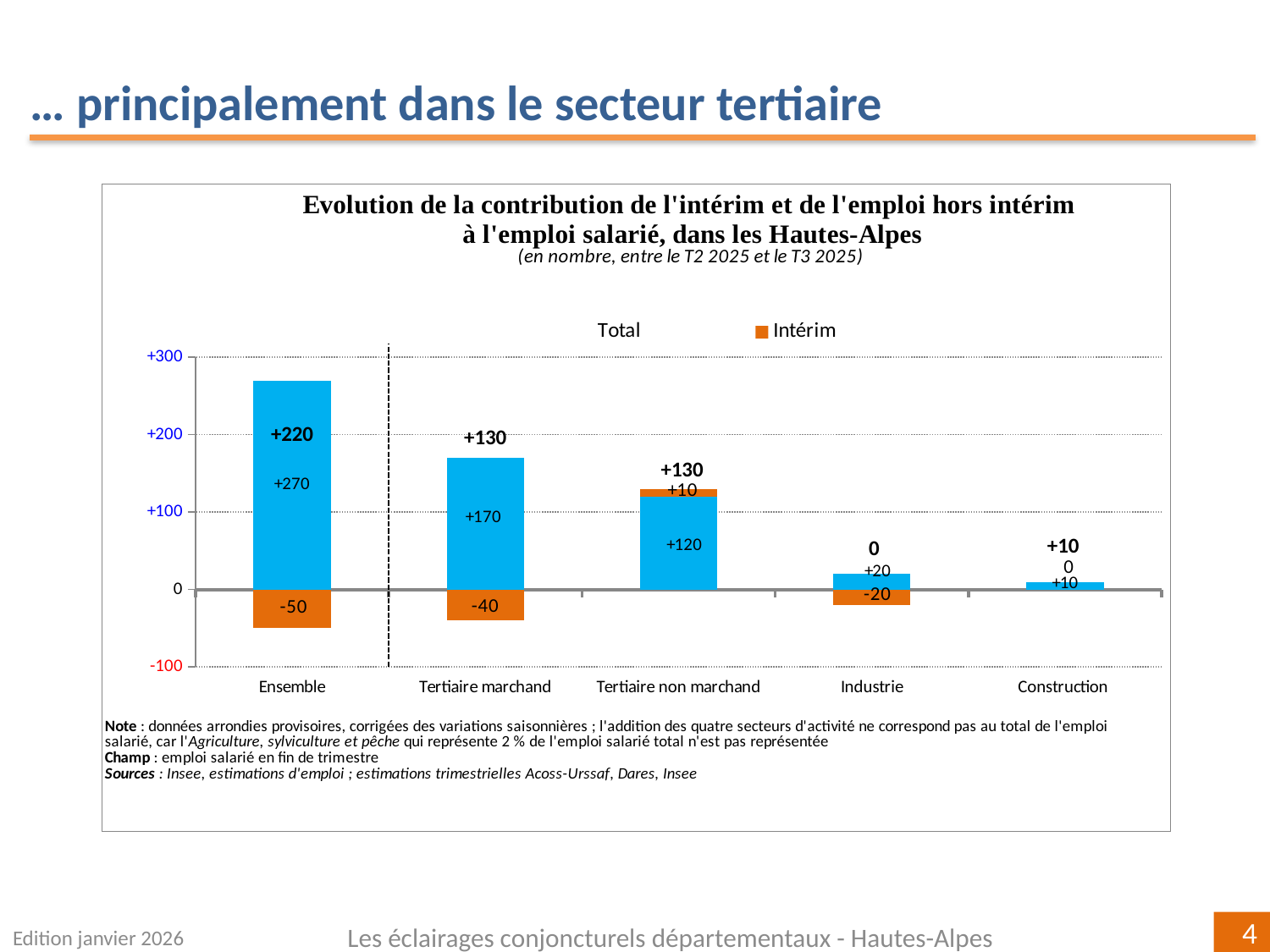
Which is larger, the Intérim value for Tertiaire non marchand or the Intérim value for Industrie? Tertiaire non marchand What is the Intérim value printed for Tertiaire marchand? -40 What is the Intérim value printed for Ensemble? -50 What is the difference between the bold total for Ensemble (+220) and the bold total for Tertiaire marchand (+130)? 90 What is the Intérim value printed for Industrie? -20 What is the total value printed above the bar for Ensemble? +220 What kind of chart is shown on the slide? Bar chart How many categories are shown on the x axis? 5 What is the total value printed above the bar for Construction? +10 How many series does the legend list? 2 Which category has the lowest total value printed in bold? Industrie What value is printed on the blue segment of the bar for Tertiaire non marchand? +120